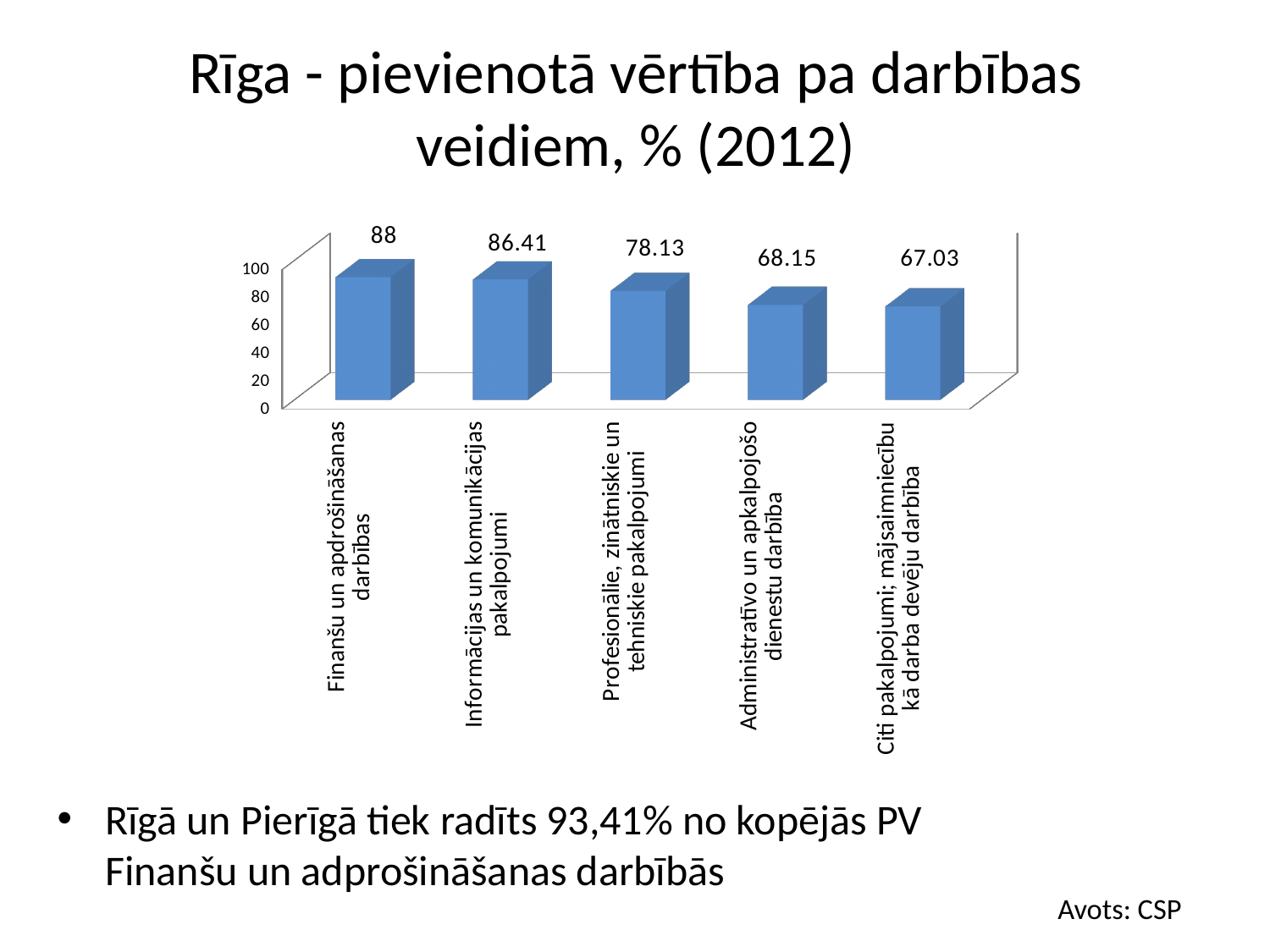
What is the value for Profesionālie, zinātniskie un tehniskie pakalpojumi? 78.13 Which category has the lowest value? Citi pakalpojumi; mājsaimniecību kā darba devēju darbība What is the difference between the values for Finanšu un apdrošināšanas darbības and Profesionālie, zinātniskie un tehniskie pakalpojumi? 9.87 Do the values rise or fall from left to right along the x axis? Fall What is the value for Informācijas un komunikācijas pakalpojumi? 86.41 Which category has the highest value? Finanšu un apdrošināšanas darbības What is the value for Administratīvo un apkalpojošo dienestu darbība? 68.15 What kind of chart is shown on the slide? Bar chart What is the value for Citi pakalpojumi; mājsaimniecību kā darba devēju darbība? 67.03 Which is larger: the value for Informācijas un komunikācijas pakalpojumi or the value for Administratīvo un apkalpojošo dienestu darbība? Informācijas un komunikācijas pakalpojumi What is the value for Finanšu un apdrošināšanas darbības? 88 How many categories are shown in the chart? 5